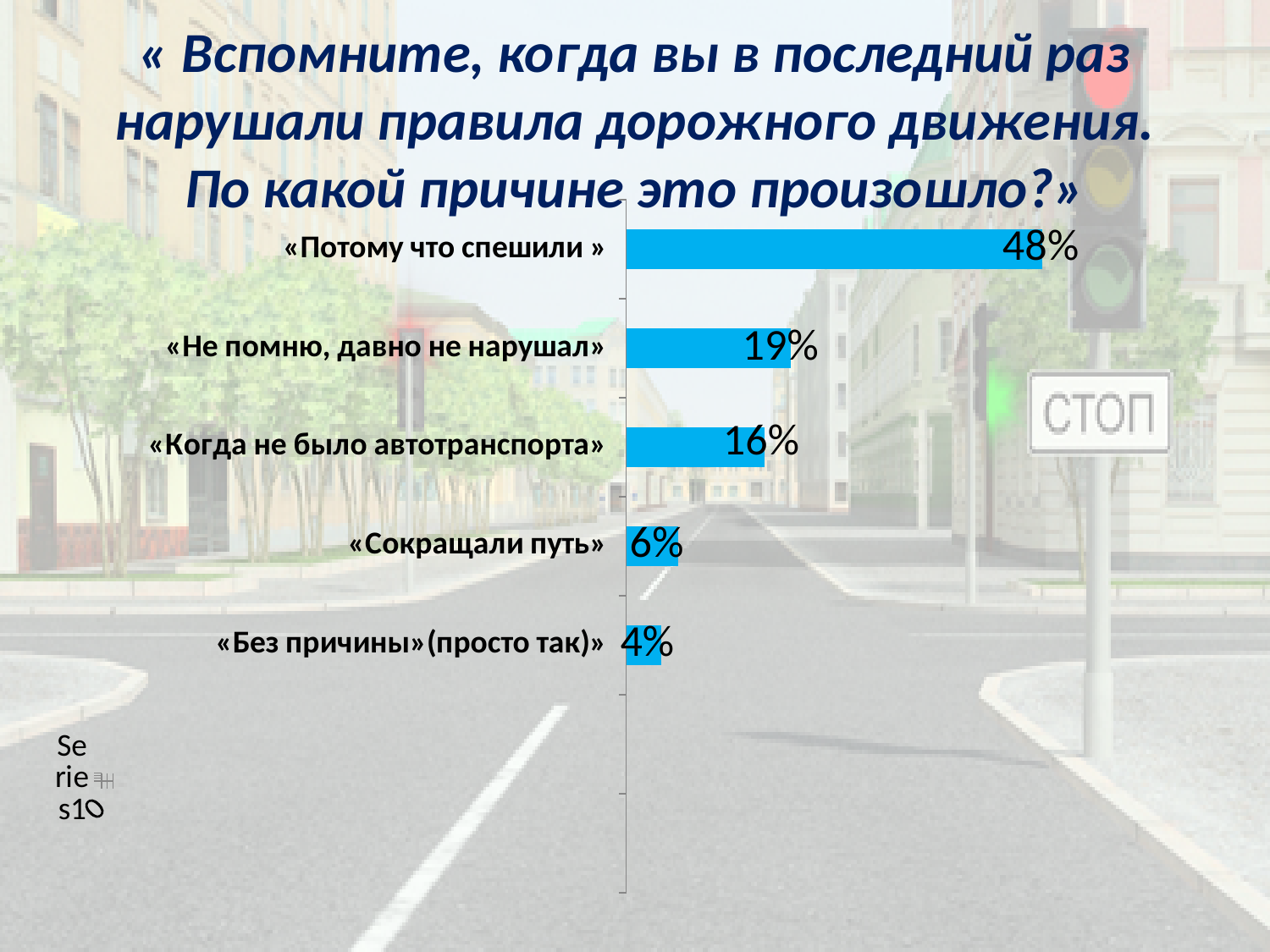
What percentage is shown for «Потому что спешили»? 48% Which is larger: the value for «Не помню, давно не нарушал» or for «Когда не было автотранспорта»? «Не помню, давно не нарушал» Which reason has the lowest percentage? «Без причины» (просто так) What value is shown for «Когда не было автотранспорта»? 16% What is the difference between the values for «Сокращали путь» and «Без причины» (просто так)? 2% How many bars are plotted in the chart? 5 Which reason has the highest percentage? «Потому что спешили» What value is shown for «Без причины» (просто так)? 4% What value is shown for «Не помню, давно не нарушал»? 19% What value is shown for «Сокращали путь»? 6% What kind of chart is shown on the slide? Bar chart What is the difference between the values for «Потому что спешили» and «Не помню, давно не нарушал»? 29%